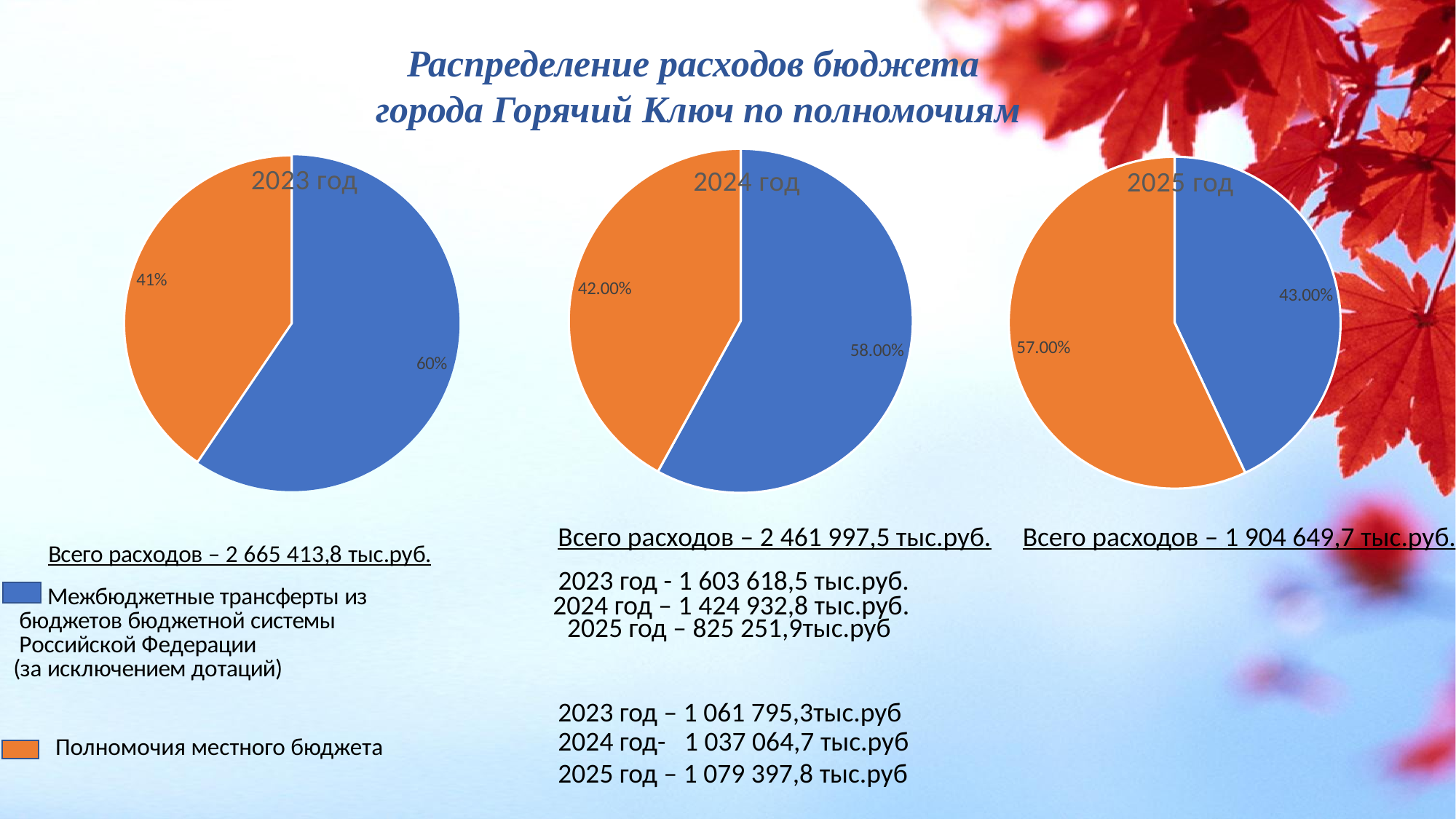
In the "2025 год" pie chart, what percentage is shown for the orange slice (Полномочия местного бюджета)? 57.00% In the "2024 год" pie chart, what percentage is shown for the orange slice (Полномочия местного бюджета)? 42.00% In the "2024 год" pie chart, what is the difference in percentage points between the blue and orange slices? 16.00 percentage points In the "2023 год" pie chart, what percentage is shown for the blue slice (Межбюджетные трансферты)? 60% In the "2024 год" pie chart, what percentage is shown for the blue slice (Межбюджетные трансферты)? 58.00% In the "2024 год" pie chart, which slice is the largest? Межбюджетные трансферты (58.00%) In the "2025 год" pie chart, which slice is larger: Межбюджетные трансферты or Полномочия местного бюджета? Полномочия местного бюджета How many pie charts are shown on the slide? 3 In the "2023 год" pie chart, what percentage is shown for the orange slice (Полномочия местного бюджета)? 41% In the "2025 год" pie chart, what percentage is shown for the blue slice (Межбюджетные трансферты)? 43.00% Which category does the orange colour represent in the legend? Полномочия местного бюджета What type of chart is used for the "2023 год" chart? Pie chart